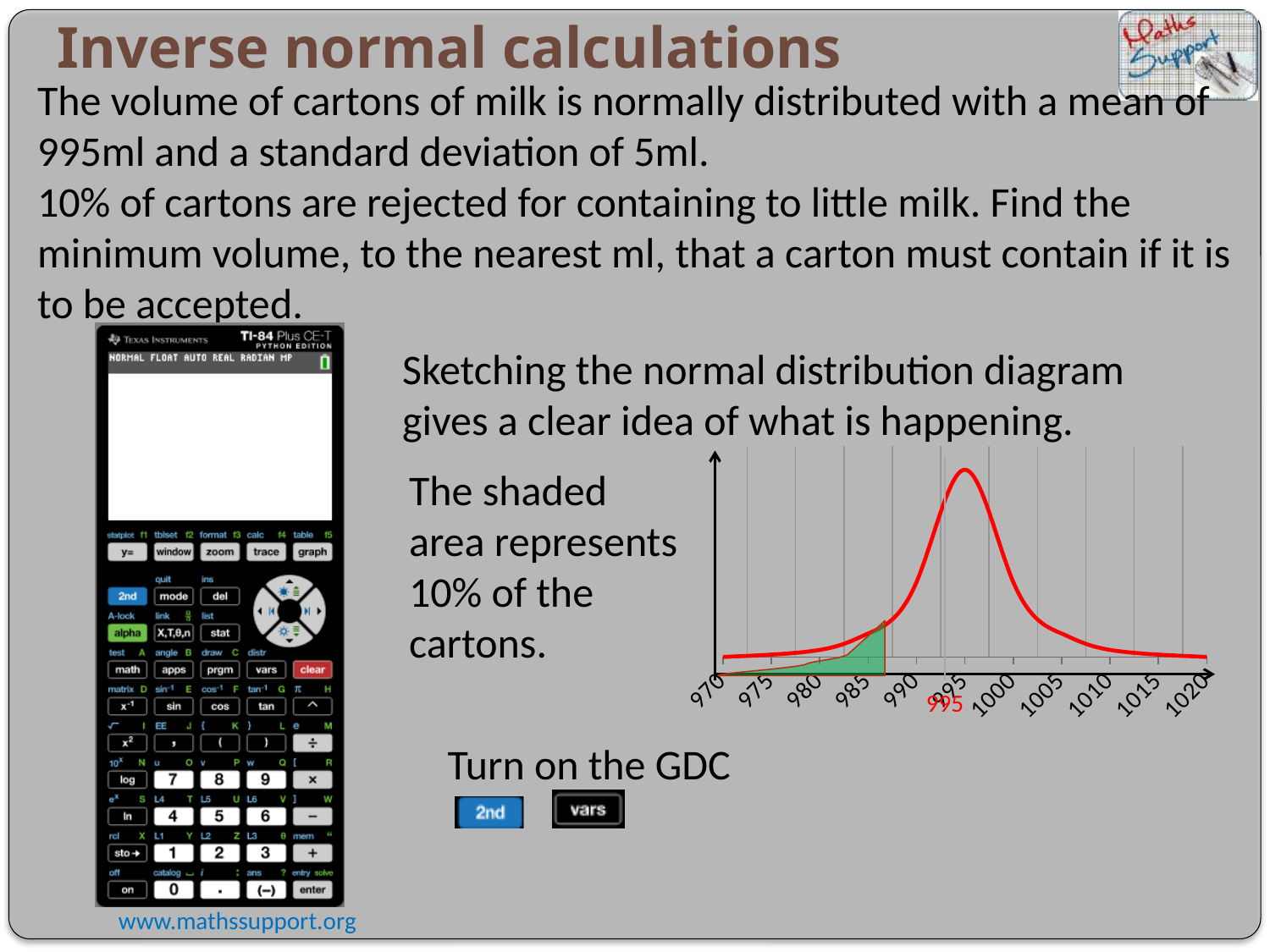
Is the right-hand boundary of the shaded area greater or less than 990? less Is the right-hand boundary of the shaded area greater or less than 985? greater What is the highest value labelled on the x axis? 1020 Which is higher on the curve, the value at 990 or the value at 1010? 990 How many labelled tick values are shown on the x axis of the chart? 11 Does the curve rise or fall as x increases from 995 to 1020? fall What percentage of the cartons does the shaded area represent? 10% What colour is the shaded area under the curve? green What kind of chart is shown on the slide? line chart Does the curve rise or fall as x increases from 970 to 995? rise What is the lowest value labelled on the x axis? 970 At which x-axis value does the curve reach its peak? 995